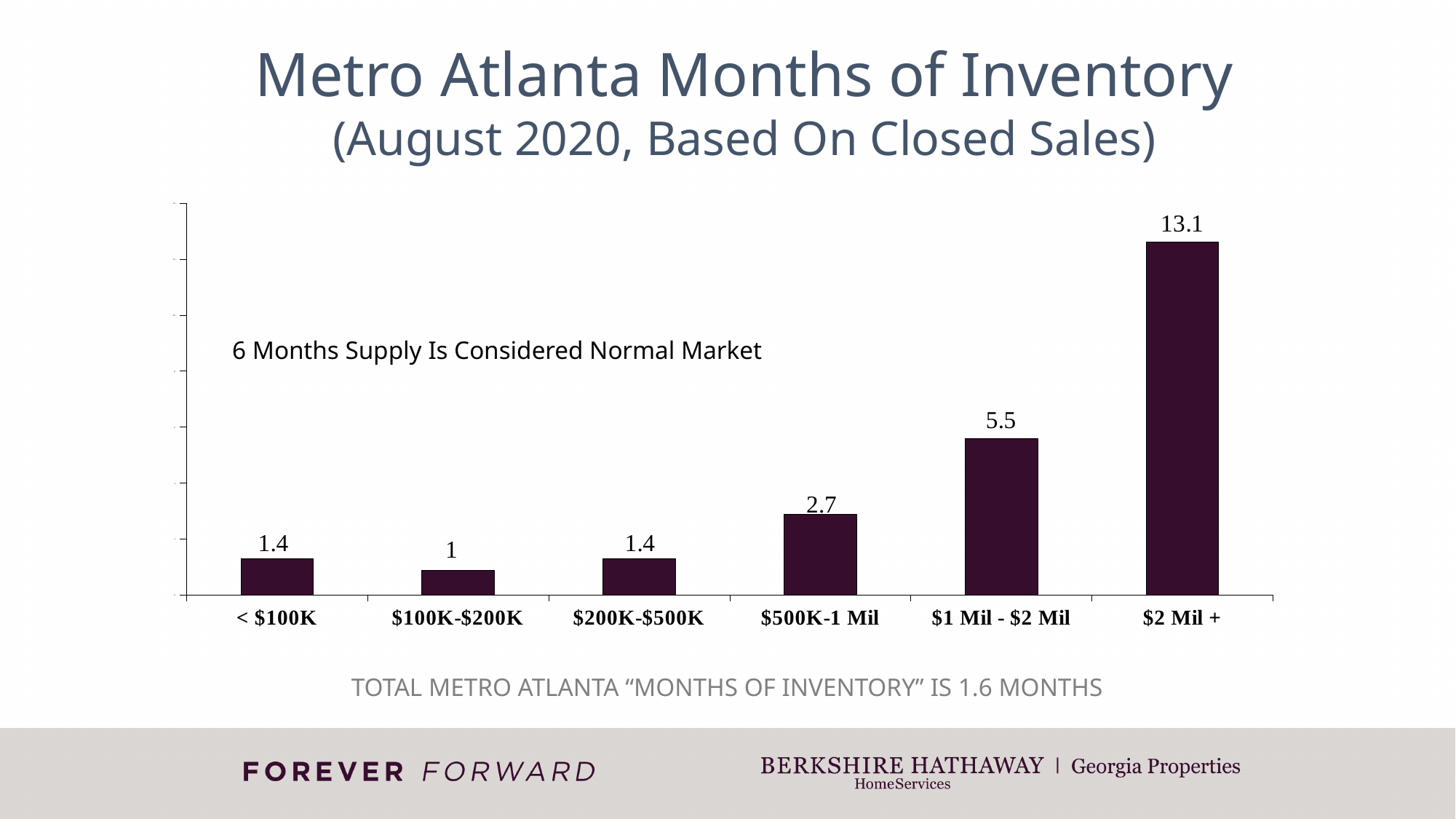
What type of chart is shown on the slide? Bar chart What is the months of inventory value for the $500K-1 Mil price range? 2.7 What is the months of inventory value for the $100K-$200K price range? 1 Which price range has the highest months of inventory? $2 Mil + How many price range categories are shown on the chart? 6 What is the difference in months of inventory between the $2 Mil + and $1 Mil - $2 Mil price ranges? 7.6 What is the difference in months of inventory between the $500K-1 Mil and $200K-$500K price ranges? 1.3 What is the months of inventory value for the $1 Mil - $2 Mil price range? 5.5 Which has a larger months of inventory value, $500K-1 Mil or $1 Mil - $2 Mil? $1 Mil - $2 Mil According to the note on the chart, how many months of supply is considered a normal market? 6 months What is the months of inventory value for the $2 Mil + price range? 13.1 Which price range has the lowest months of inventory? $100K-$200K